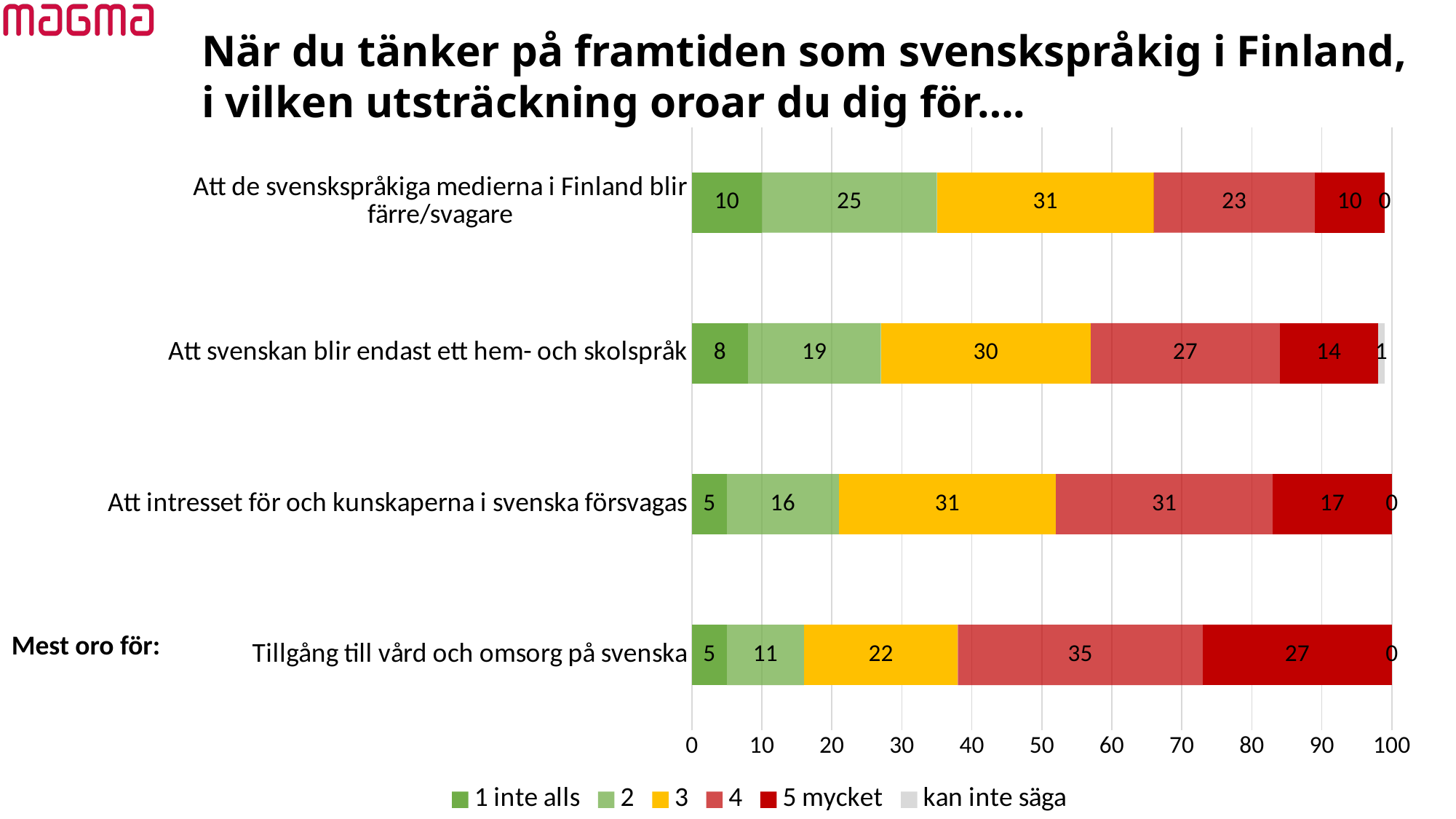
How many series does the legend list? 6 Which category has the larger "3" value: "Att de svenskspråkiga medierna i Finland blir färre/svagare" or "Tillgång till vård och omsorg på svenska"? Att de svenskspråkiga medierna i Finland blir färre/svagare Which category has the lowest value for the "2" series? Tillgång till vård och omsorg på svenska How many categories (bars) does the chart show? 4 What is the difference between the "4" value for "Tillgång till vård och omsorg på svenska" and the "4" value for "Att de svenskspråkiga medierna i Finland blir färre/svagare"? 12 What is the total of the stacked bar for "Tillgång till vård och omsorg på svenska"? 100 What is the value of the "kan inte säga" segment for "Att svenskan blir endast ett hem- och skolspråk"? 1 What kind of chart is shown on the slide? bar chart What is the value of the "5 mycket" segment for "Tillgång till vård och omsorg på svenska"? 27 What is the value of the "3" segment for "Att svenskan blir endast ett hem- och skolspråk"? 30 Which category has the highest value for the "5 mycket" series? Tillgång till vård och omsorg på svenska What is the first entry in the chart's legend? 1 inte alls